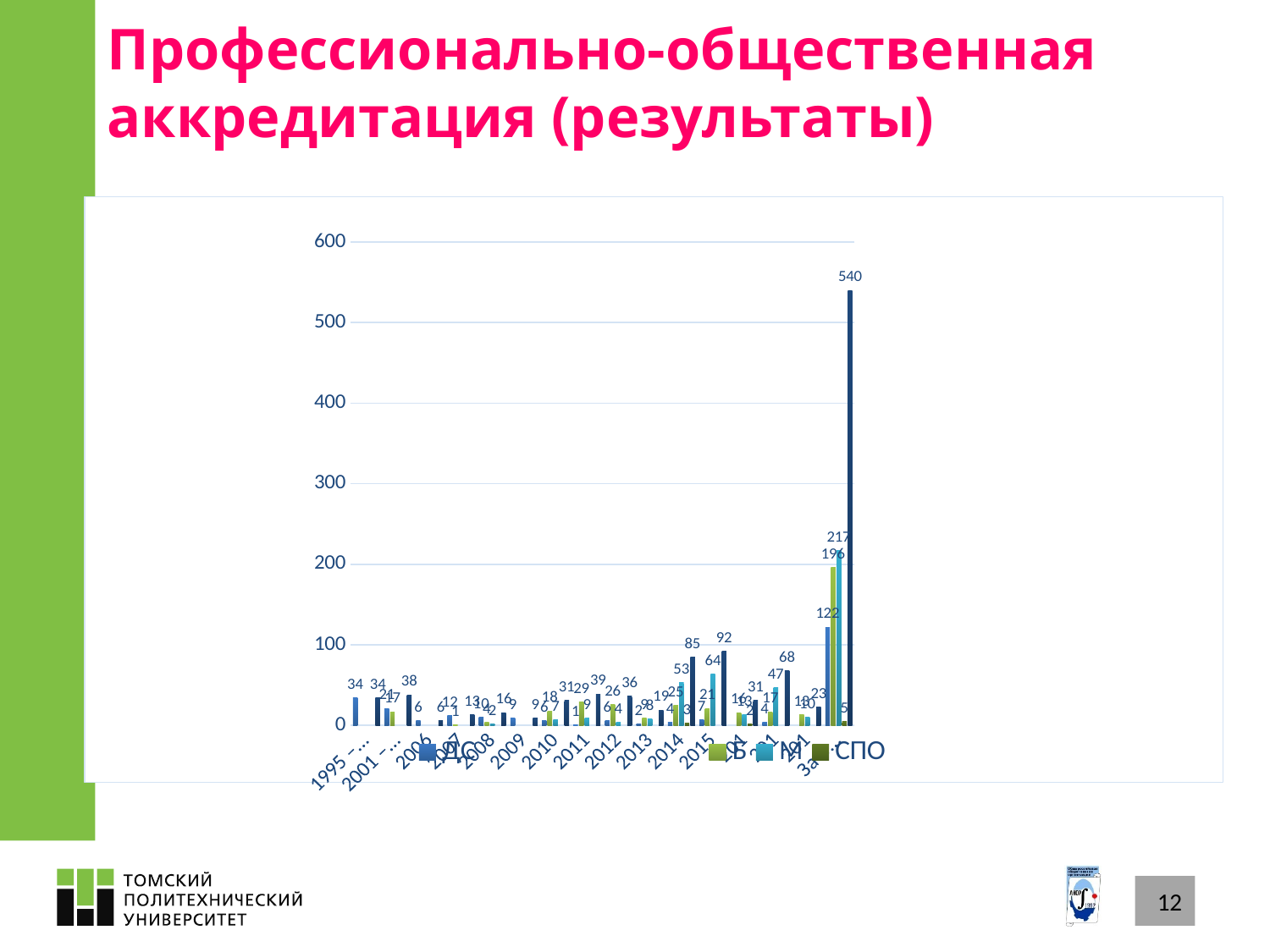
Is the tallest bar's value greater or less than 500? greater Is the bar labelled 217 greater or less than 200? greater What is the title of the slide containing the chart? Профессионально-общественная аккредитация (результаты) Do the bar heights generally rise or fall from left to right along the x axis? rise What is the difference between the bars labelled 217 and 196? 21 What is the highest value labelled on the chart? 540 Which is larger, the bar labelled 540 or the bar labelled 217? 540 What is the difference between the bars labelled 540 and 217? 323 What kind of chart is shown on the slide? bar chart Is the bar labelled 196 greater or less than 200? less What is the maximum value shown on the vertical axis? 600